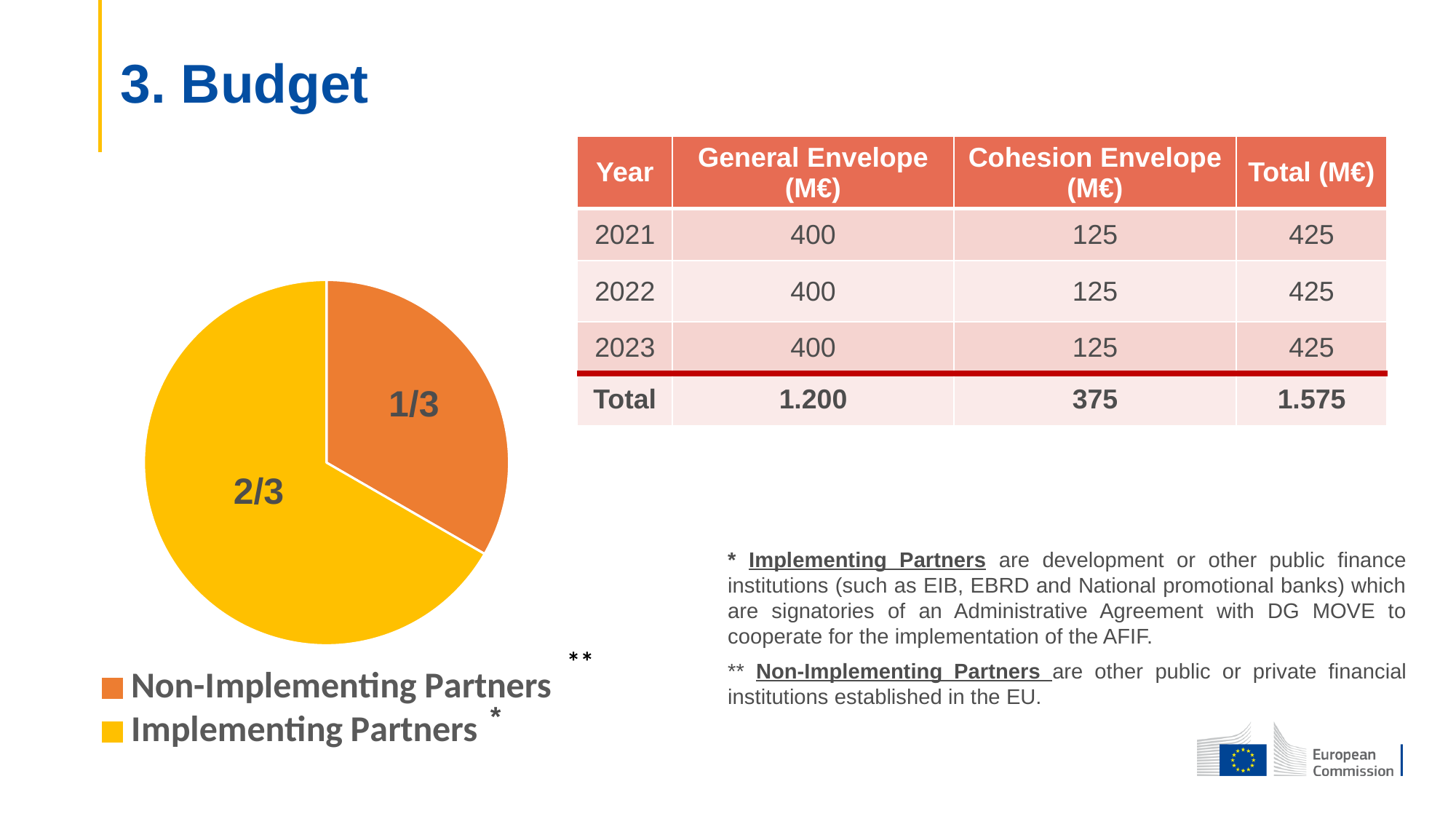
What colour is the Non-Implementing Partners slice in the pie chart? orange Which slice of the pie chart is the largest? Implementing Partners What share of the pie chart is labelled for Implementing Partners? 2/3 In the pie chart, which is larger: Implementing Partners or Non-Implementing Partners? Implementing Partners How many slices does the pie chart have? 2 What share of the pie chart is labelled for Non-Implementing Partners? 1/3 What colour is the Implementing Partners slice in the pie chart? yellow What kind of chart is shown on the slide? pie chart Which slice of the pie chart is the smallest? Non-Implementing Partners How many entries does the pie chart's legend list? 2